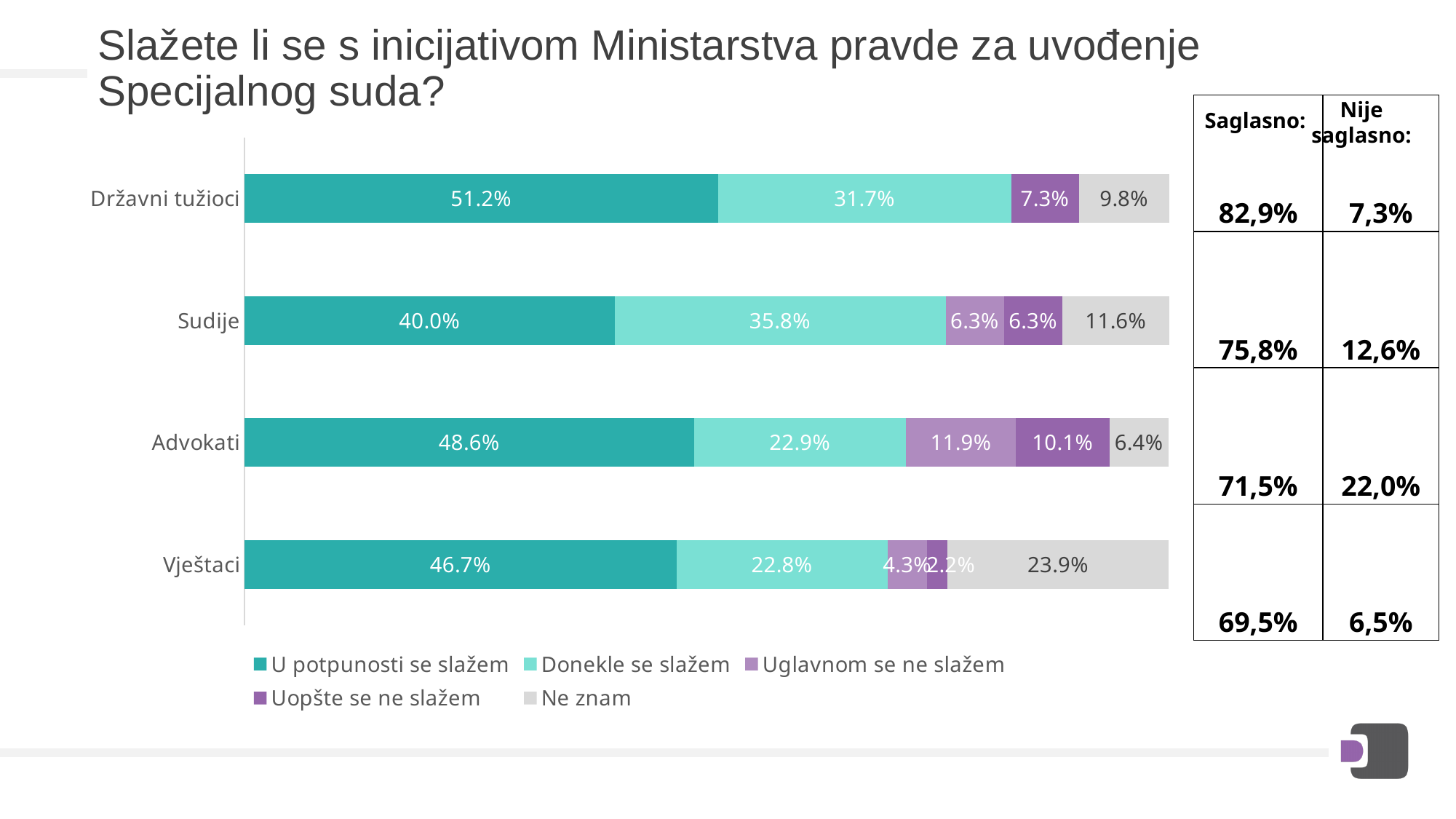
Which category has the lowest value for 'Ne znam'? Advokati What is the value of 'Ne znam' for Vještaci? 23.9% What is the value of 'Donekle se slažem' for Sudije? 35.8% How many categories (respondent groups) are shown on the chart? 4 What is the value of 'U potpunosti se slažem' for Državni tužioci? 51.2% Which legend entry is shown in the grey colour? Ne znam What is the value of 'Uopšte se ne slažem' for Advokati? 10.1% Which category has the highest value for 'U potpunosti se slažem'? Državni tužioci Which is larger: the 'Donekle se slažem' value for Advokati or for Vještaci? Advokati What is the difference between the 'U potpunosti se slažem' values for Državni tužioci and Sudije? 11.2% How many series does the chart legend list? 5 What kind of chart is shown on the slide? stacked bar chart